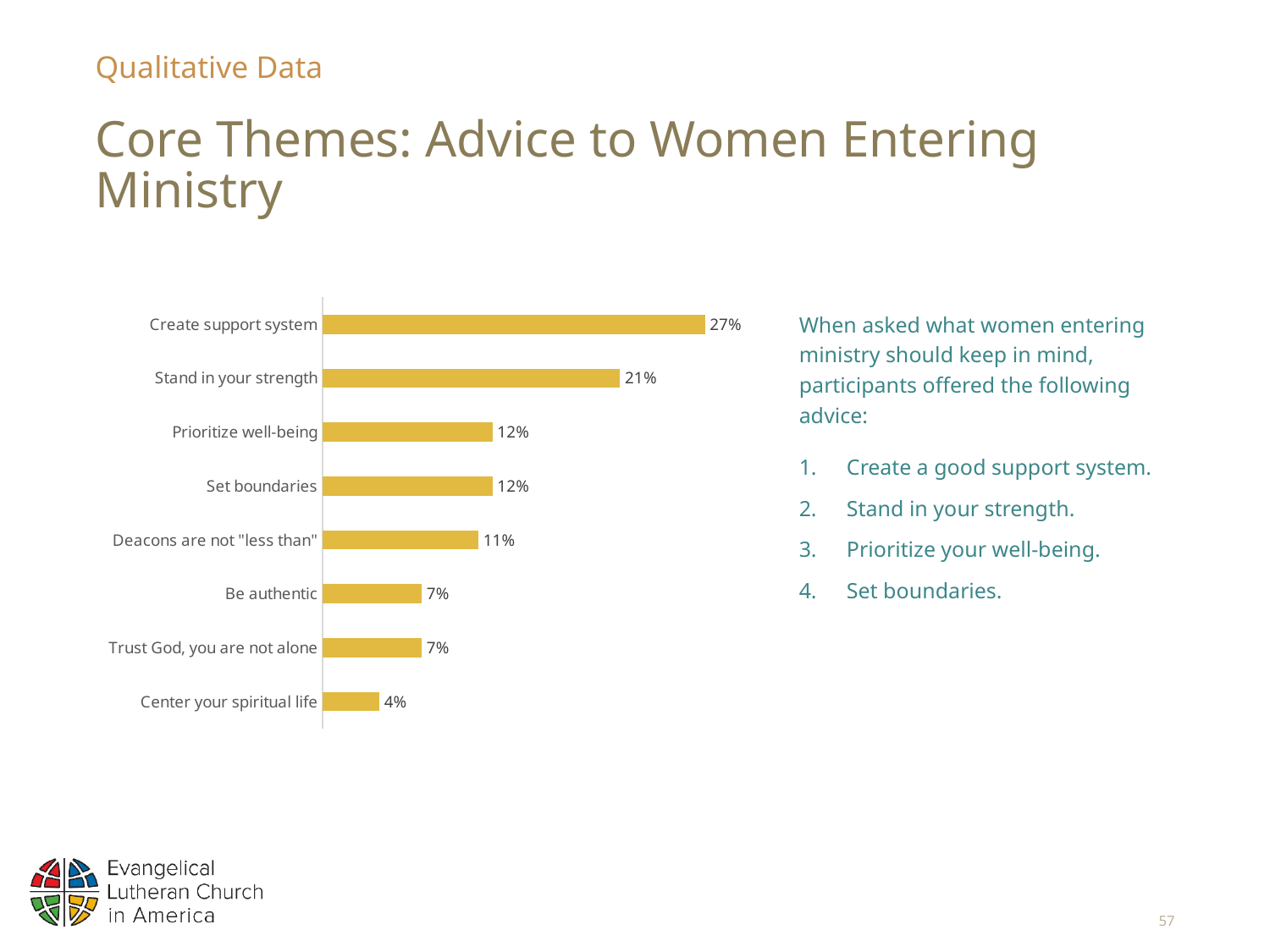
How many categories are shown in the chart? 8 What colour are the bars in the chart? Gold What kind of chart is shown on the slide? Bar chart What percentage is shown for "Create support system"? 27% Which category has the highest value? Create support system Which is larger, the value for "Set boundaries" or the value for "Trust God, you are not alone"? Set boundaries What percentage is shown for "Deacons are not "less than""? 11% What is the value for "Stand in your strength"? 21% What is the difference between the values for "Prioritize well-being" and "Be authentic"? 5% What is the difference between the values for "Create support system" and "Stand in your strength"? 6% What is the value for "Center your spiritual life"? 4% Which category has the lowest value? Center your spiritual life